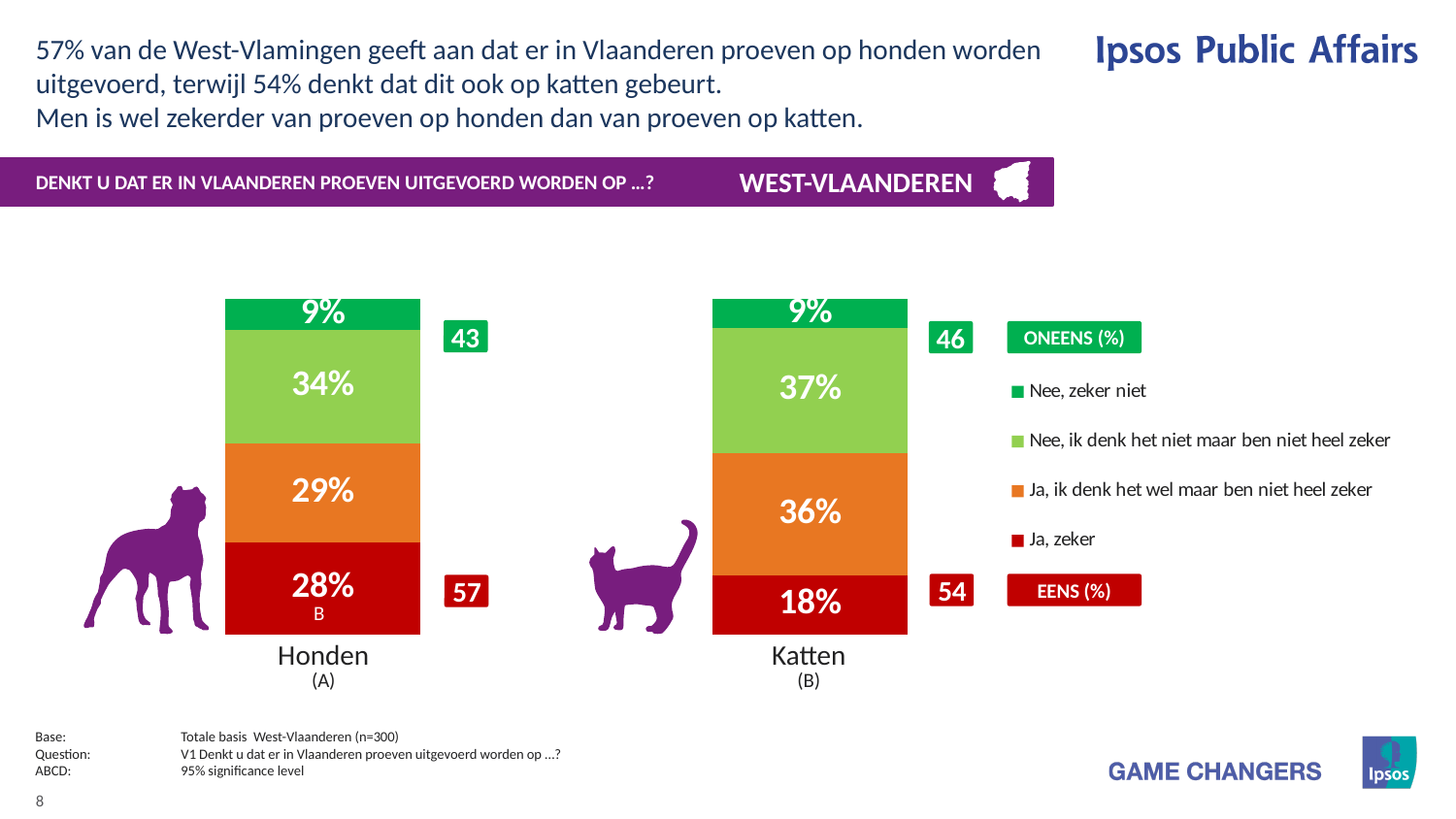
What is the difference between the "Ja, ik denk het wel maar ben niet heel zeker" values for Katten and Honden? 7 percentage points What is the ONEENS (%) total shown for Katten? 46 What is the EENS (%) total shown for Honden? 57 What is the difference between the "Ja, zeker" values for Honden and Katten? 10 percentage points What kind of chart is shown on the slide? Stacked bar chart Which category has the larger "Ja, zeker" share, Honden or Katten? Honden How many categories are shown on the x axis? 2 What percentage of respondents answered "Ja, zeker" for Katten? 18% What percentage of respondents answered "Ja, zeker" for Honden? 28% What is the value of "Ja, ik denk het wel maar ben niet heel zeker" for Honden? 29% What is the value of "Nee, ik denk het niet maar ben niet heel zeker" for Katten? 37% How many series does the legend list? 4